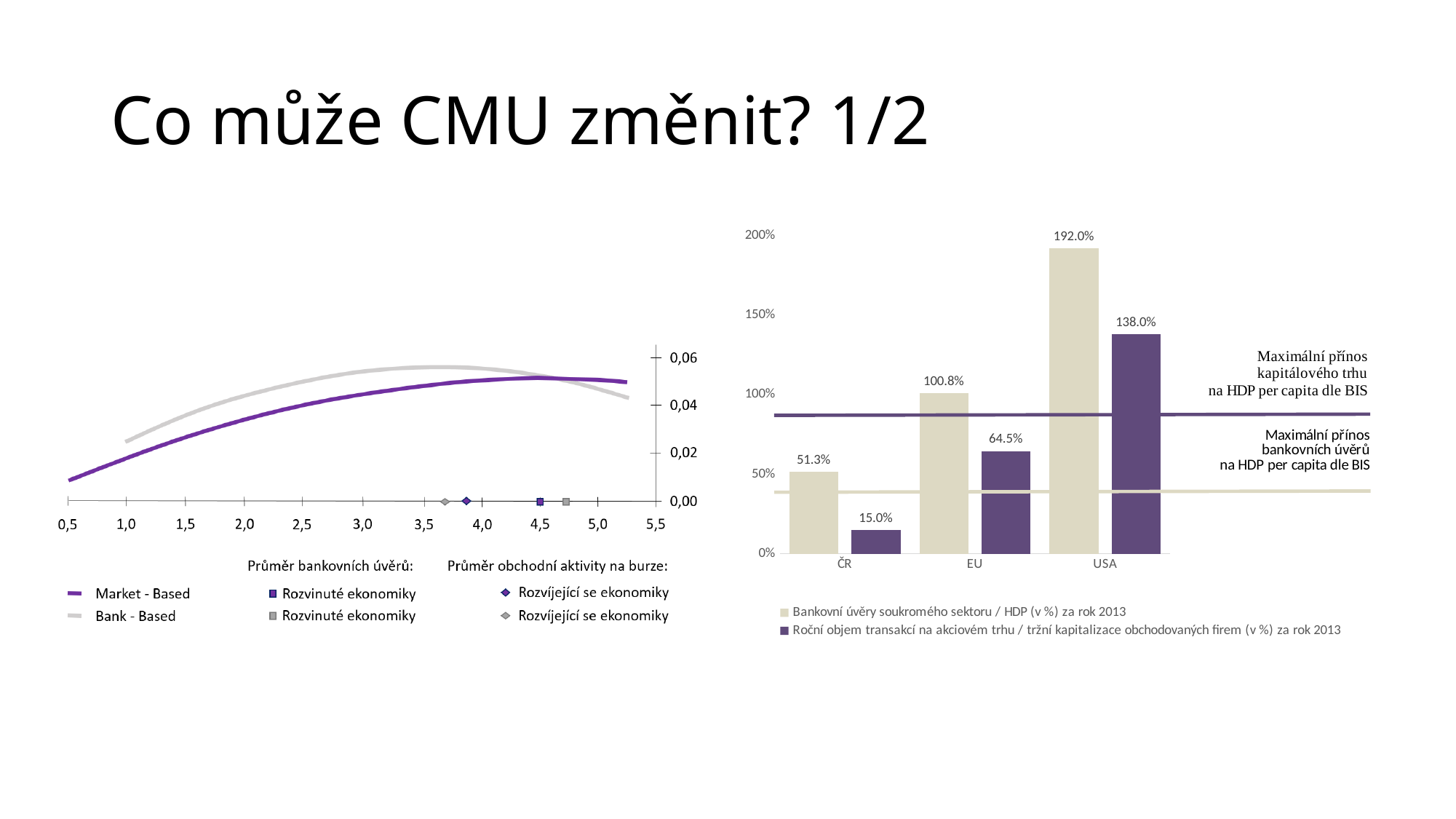
In the bar chart on the right, what is the value of bank loans to the private sector / GDP (Bankovní úvěry soukromého sektoru / HDP) for USA? 192.0% How many categories are shown on the x axis of the bar chart on the right? 3 In the bar chart on the right, which category has the lowest value for bank loans to the private sector / GDP? ČR In the bar chart on the right, what is the value of the annual stock market transaction volume series (Roční objem transakcí na akciovém trhu) for ČR? 15.0% In the bar chart on the right, which category has the highest value for the annual stock market transaction volume series? USA In the bar chart on the right, which is larger: the stock market transaction volume value for EU or the bank loans / GDP value for ČR? the stock market transaction volume value for EU In the bar chart on the right, what is the value of bank loans to the private sector / GDP for EU? 100.8% In the line chart on the left, is the Market - Based value at x = 0.5 greater or less than 0.02? less In the bar chart on the right, what is the difference between the two series' values for ČR? 36.3% In the line chart on the left, which two curves are plotted according to the legend? Market - Based and Bank - Based What kind of chart is the chart on the left of the slide? line chart In the bar chart on the right, what is the difference between the bank loans / GDP value for USA and for EU? 91.2%